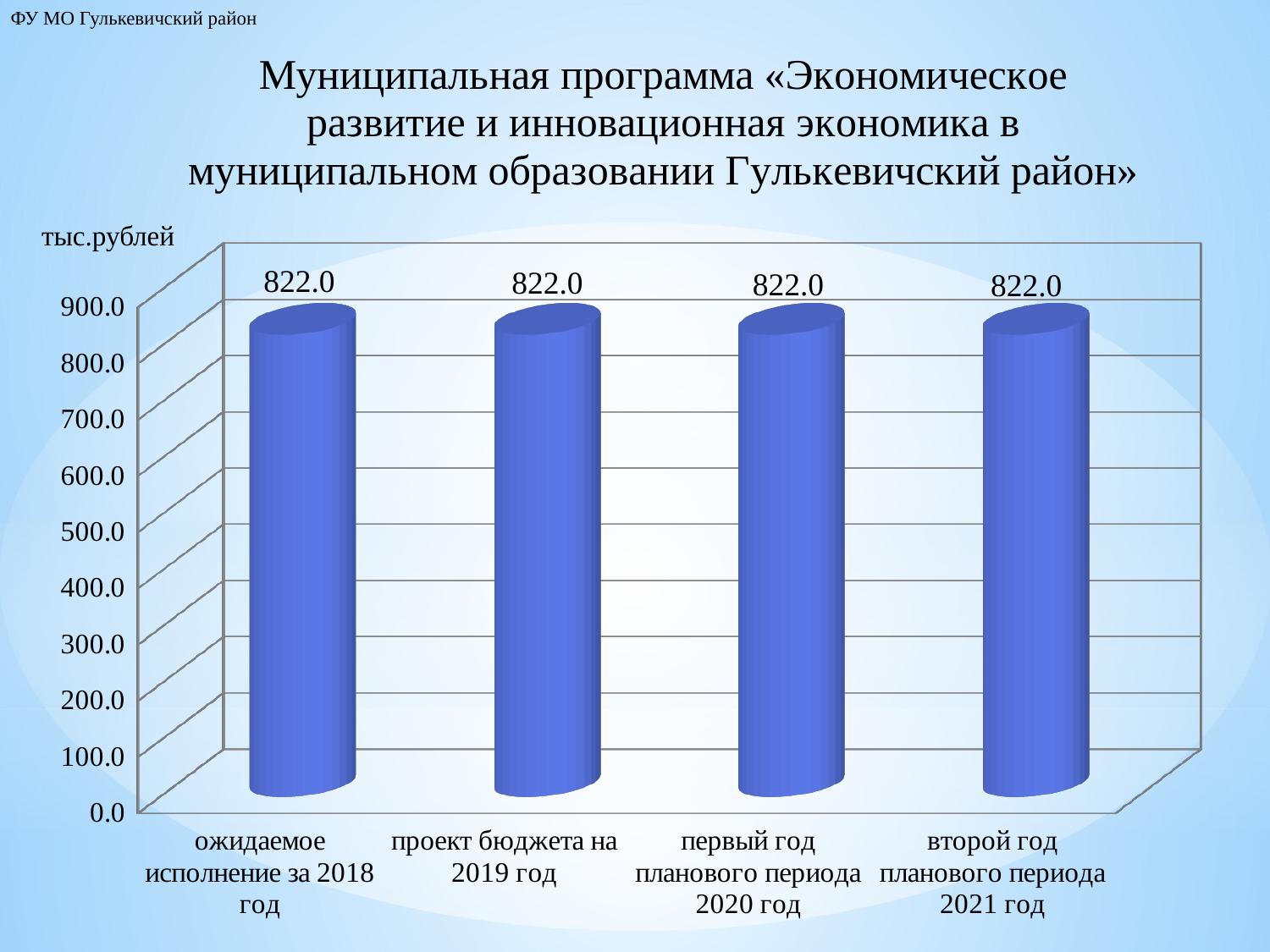
What is the value for «ожидаемое исполнение за 2018 год»? 822.0 Is the value for «проект бюджета на 2019 год» greater or less than 800.0? greater What is the value for «второй год планового периода 2021 год»? 822.0 Do the values rise, fall, or stay the same from 2018 to 2021? Stay the same How many bars (categories) are shown in the chart? 4 What colour are the bars in the chart? Blue Is the value for «второй год планового периода 2021 год» greater or less than 900.0? less What unit is shown for the values on the chart? тыс.рублей What is the value for «проект бюджета на 2019 год»? 822.0 What kind of chart is shown on the slide? Bar chart What is the value for «первый год планового периода 2020 год»? 822.0 What is the difference between the value for 2021 and the value for 2018? 0.0